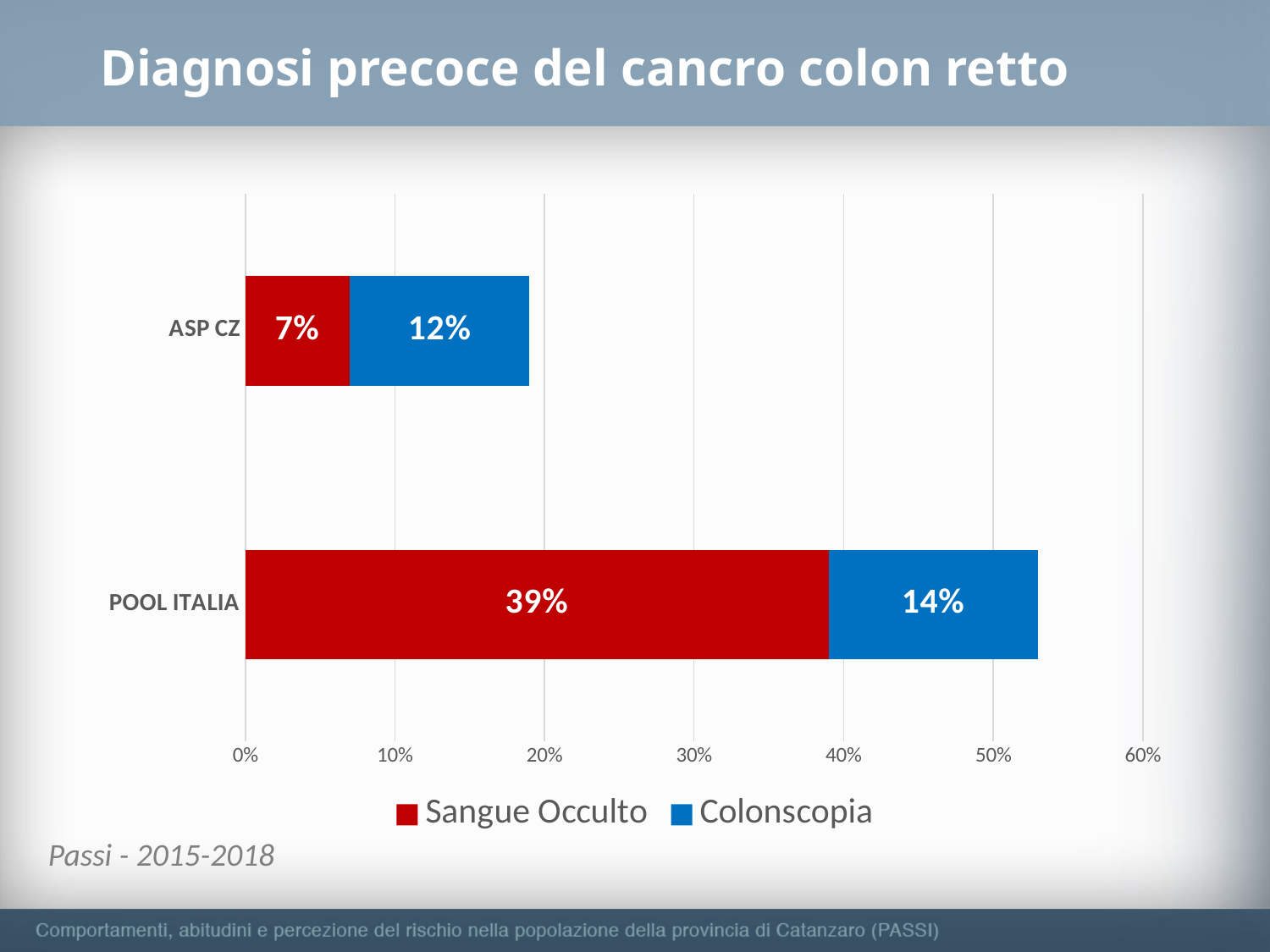
What is the difference between the Sangue Occulto values for POOL ITALIA and ASP CZ? 32% How many series does the legend list? 2 What is the Colonscopia value for POOL ITALIA? 14% Is the Colonscopia value for POOL ITALIA larger or smaller than the Colonscopia value for ASP CZ? larger What is the Sangue Occulto value for ASP CZ? 7% What kind of chart is shown on the slide? stacked bar chart What is the Colonscopia value for ASP CZ? 12% What is the total of the stacked bar for POOL ITALIA? 53% What is the total of the stacked bar for ASP CZ? 19% Which category has the higher Sangue Occulto value? POOL ITALIA How many categories are shown on the chart? 2 What is the Sangue Occulto value for POOL ITALIA? 39%